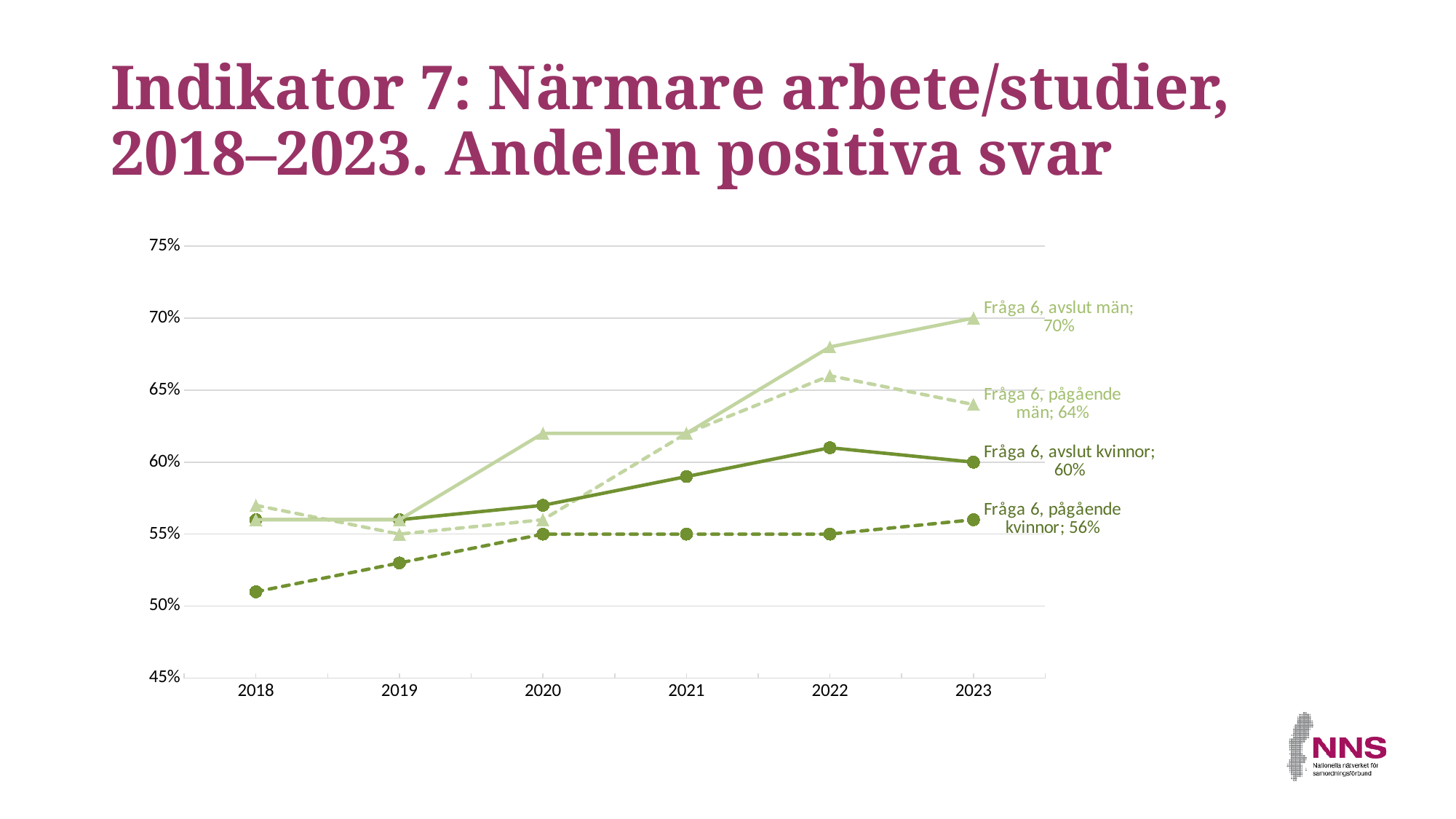
What is the value for Fråga 6, avslut män in 2023? 70% Is the value for Fråga 6, pågående kvinnor in 2018 greater or less than 55%? less Which series has the lowest value in 2023? Fråga 6, pågående kvinnor What is the value for Fråga 6, pågående kvinnor in 2023? 56% What is the value for Fråga 6, pågående män in 2023? 64% How many years are shown on the x axis? 6 What kind of chart is shown on the slide? line chart What is the value for Fråga 6, avslut kvinnor in 2023? 60% In 2023, which is larger: Fråga 6, pågående män or Fråga 6, avslut kvinnor? Fråga 6, pågående män What is the difference between Fråga 6, avslut män and Fråga 6, pågående kvinnor in 2023? 14 percentage points Is the value for Fråga 6, avslut män in 2022 greater or less than 65%? greater Which series has the highest value in 2023? Fråga 6, avslut män